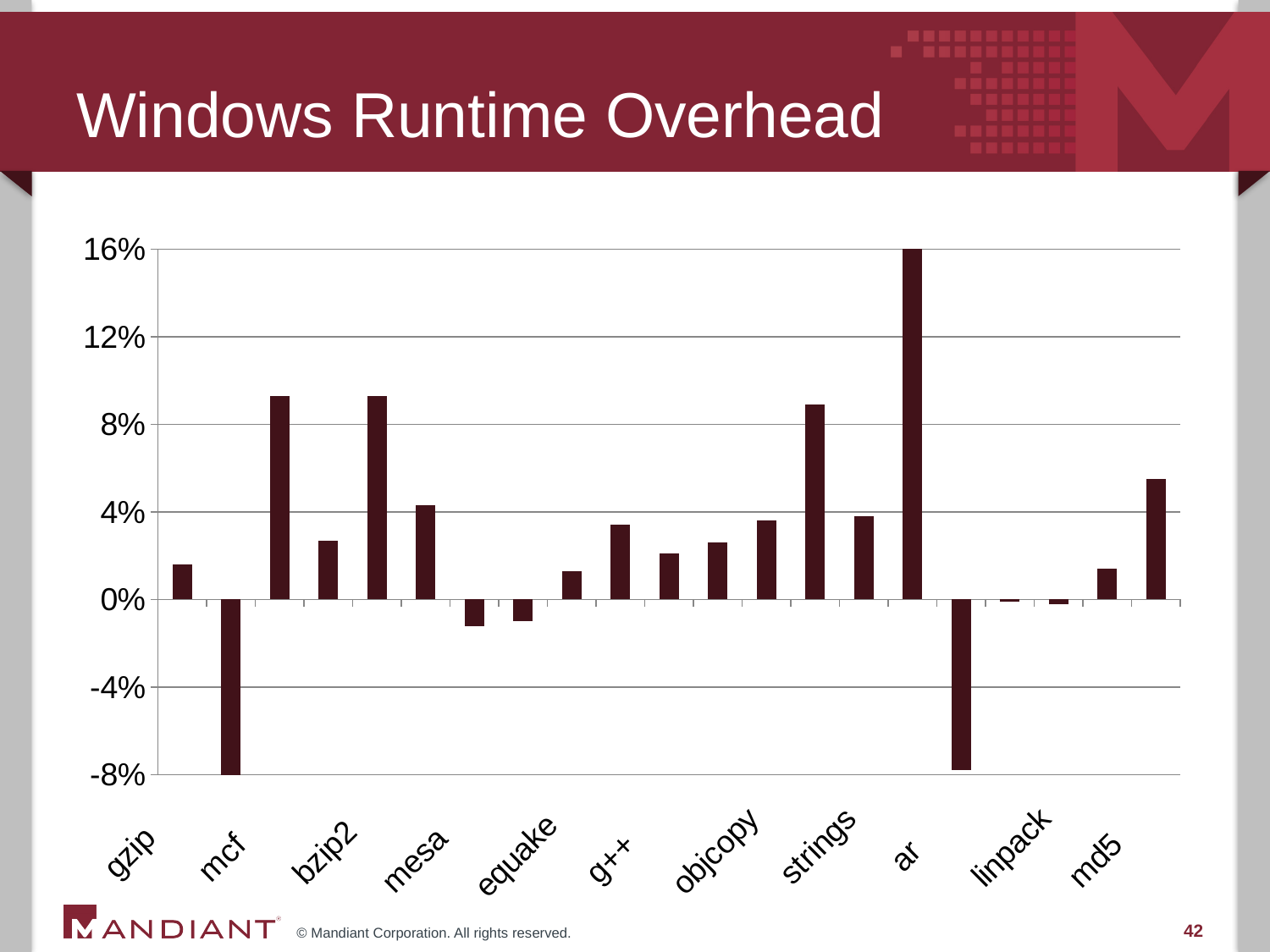
What is the title of the slide containing the chart? Windows Runtime Overhead Which is larger, the value for md5 or the value for gzip? md5 Is the value for md5 greater or less than 4%? greater What kind of chart is shown on the slide? bar chart What is the highest value shown on the y axis? 16% How many category labels are printed along the x axis? 11 How many bars are plotted in the chart? 21 What is the value reached by the tallest bar in the chart? 16% What is the lowest value shown on the y axis? -8% Is the value for gzip greater or less than 4%? less